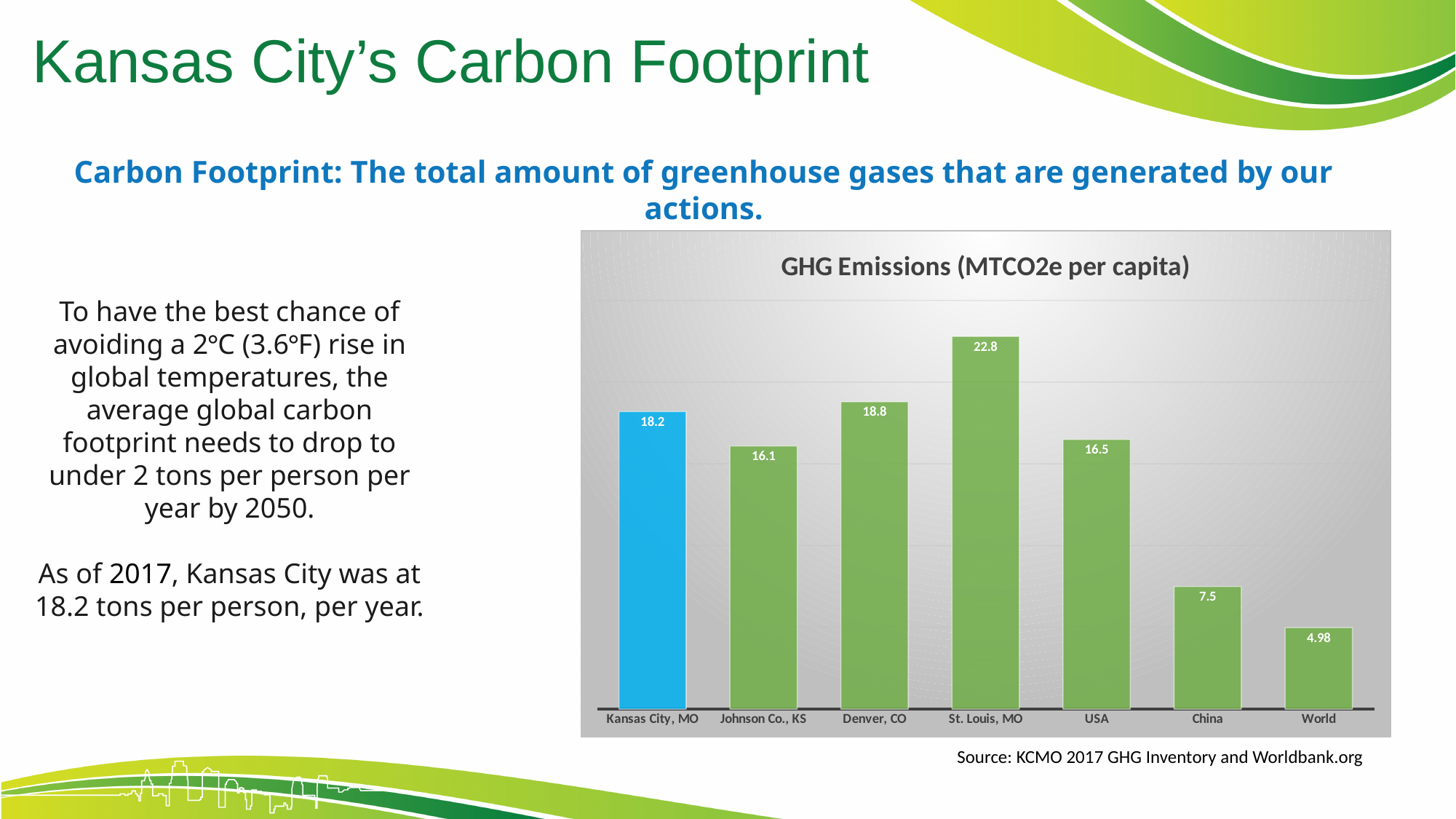
What is the title of the chart? GHG Emissions (MTCO2e per capita) What is the GHG emissions value for China? 7.5 Which category has the lowest GHG emissions per capita? World What is the GHG emissions value for St. Louis, MO? 22.8 Which has a higher value, Denver, CO or Johnson Co., KS? Denver, CO What kind of chart is shown on the slide? Bar chart What is the GHG emissions value for Kansas City, MO? 18.2 What is the GHG emissions value for the World? 4.98 How many categories are shown in the chart? 7 Which category has the highest GHG emissions per capita? St. Louis, MO What is the difference between the values for St. Louis, MO and Kansas City, MO? 4.6 What is the difference between the values for USA and China? 9